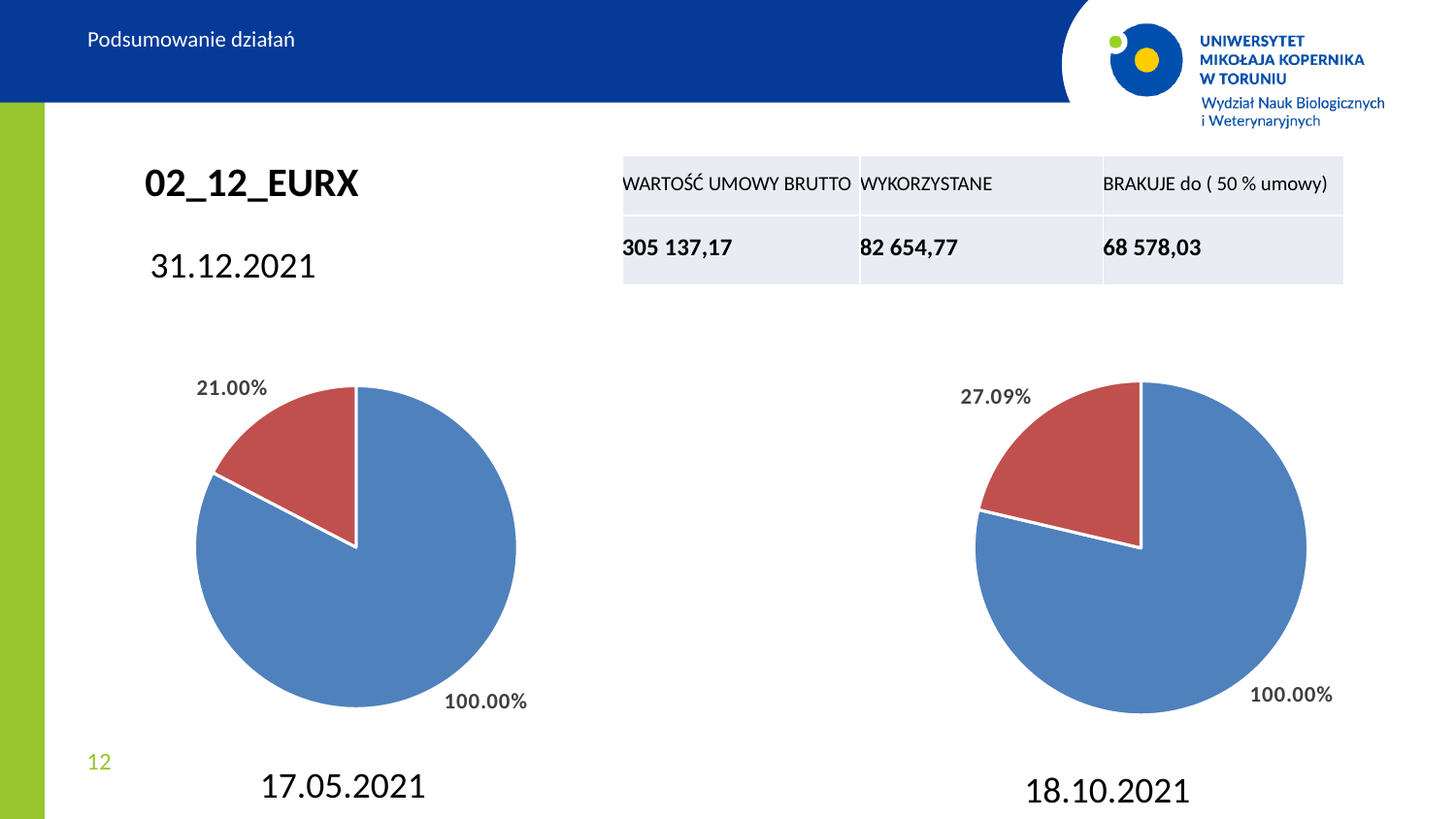
In the left pie chart (17.05.2021), which slice is larger, the red one or the blue one? the blue one In the right pie chart (18.10.2021), what percentage label is printed next to the red slice? 27.09% How many slices does the right pie chart (18.10.2021) have? 2 Which pie chart has the larger red slice, the one dated 17.05.2021 or the one dated 18.10.2021? 18.10.2021 What colour is the smaller slice in both pie charts on the slide? red What kind of chart is shown on the left side of the slide, above the date 17.05.2021? pie chart How many slices does the left pie chart (17.05.2021) have? 2 In the left pie chart (17.05.2021), what percentage label is printed next to the blue slice? 100.00% What kind of chart is shown on the right side of the slide, above the date 18.10.2021? pie chart What is the difference between the red slice labels of the right pie chart (27.09%) and the left pie chart (21.00%)? 6.09% In the left pie chart (17.05.2021), what percentage label is printed next to the red slice? 21.00% In the right pie chart (18.10.2021), what percentage label is printed next to the blue slice? 100.00%